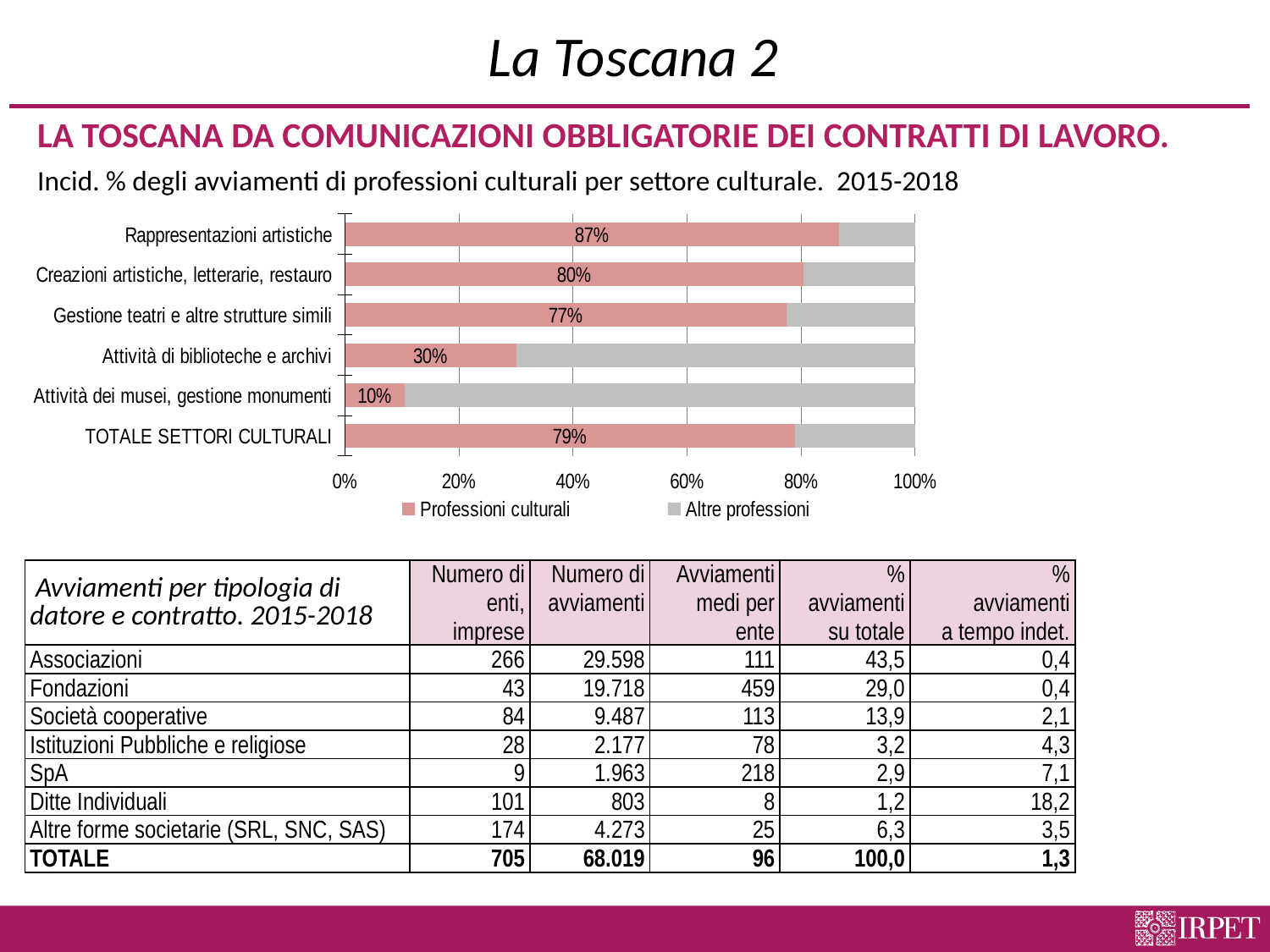
What is the value for Professioni culturali in Attività di biblioteche e archivi? 30% What is the value for Professioni culturali in TOTALE SETTORI CULTURALI? 79% What is the value for Professioni culturali in Rappresentazioni artistiche? 87% Which has a larger Professioni culturali value: Attività di biblioteche e archivi or Attività dei musei, gestione monumenti? Attività di biblioteche e archivi What kind of chart is shown on the slide? Stacked bar chart How many categories are shown on the chart? 6 Which series is shown in grey in the chart? Altre professioni Which category has the lowest value for Professioni culturali? Attività dei musei, gestione monumenti Is the value for Altre professioni in Attività dei musei, gestione monumenti greater or less than 80%? greater Which category has the highest value for Professioni culturali? Rappresentazioni artistiche What is the difference between the Professioni culturali values for Creazioni artistiche, letterarie, restauro and Gestione teatri e altre strutture simili? 3% How many series does the legend list? 2